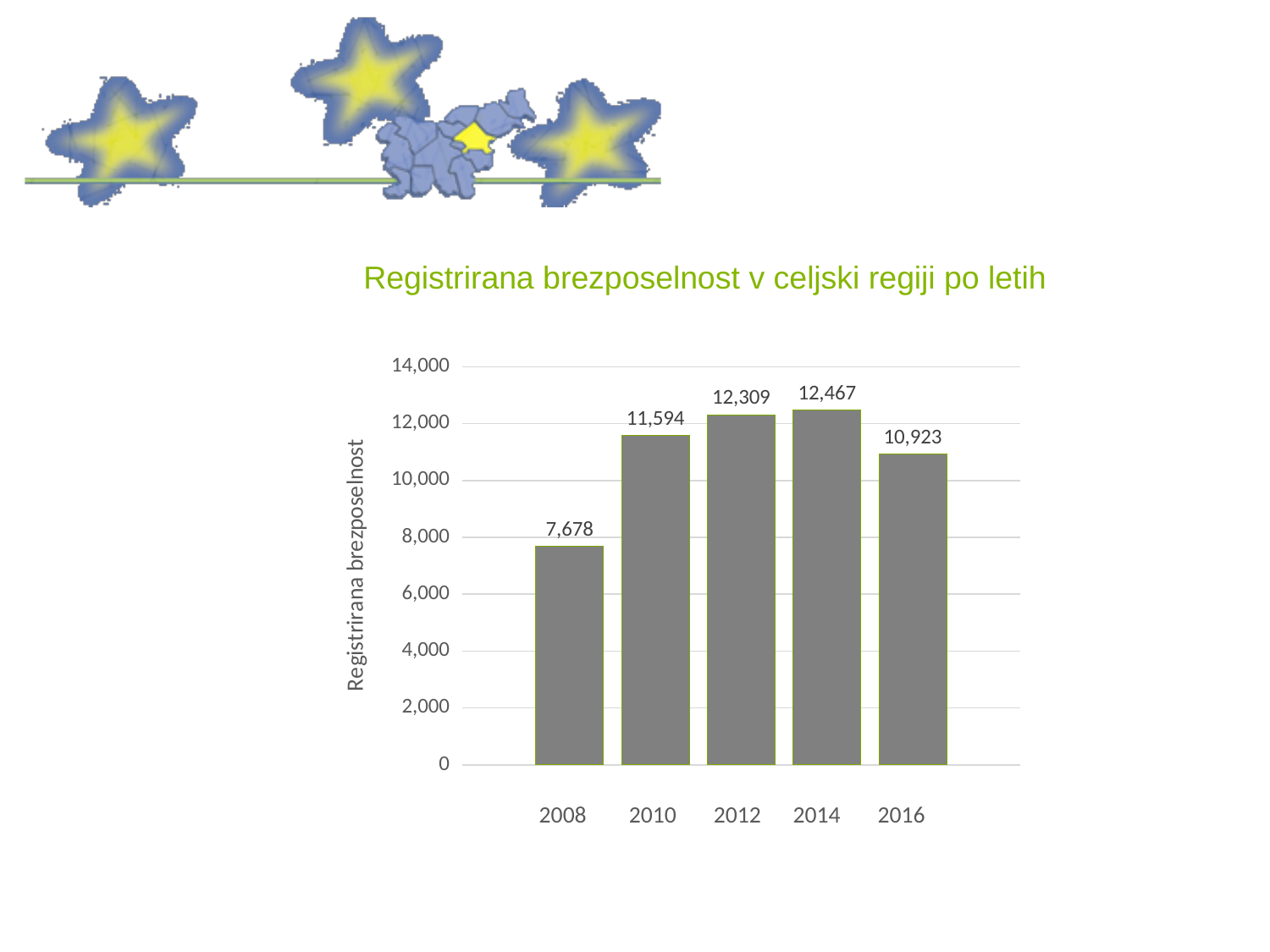
What is the difference between the values for 2014 and 2008? 4,789 What is the registered unemployment value for 2016? 10,923 What is the value shown for 2012? 12,309 What is the title of the chart? Registrirana brezposelnost v celjski regiji po letih Which year has the highest registered unemployment? 2014 How many years are shown on the x axis? 5 What kind of chart is shown on the slide? bar chart Is the value for 2010 greater or less than 10,000? greater Which is larger, the value for 2010 or the value for 2016? 2010 What is the registered unemployment value for 2008? 7,678 What is the difference between the values for 2014 and 2016? 1,544 Which year has the lowest registered unemployment? 2008